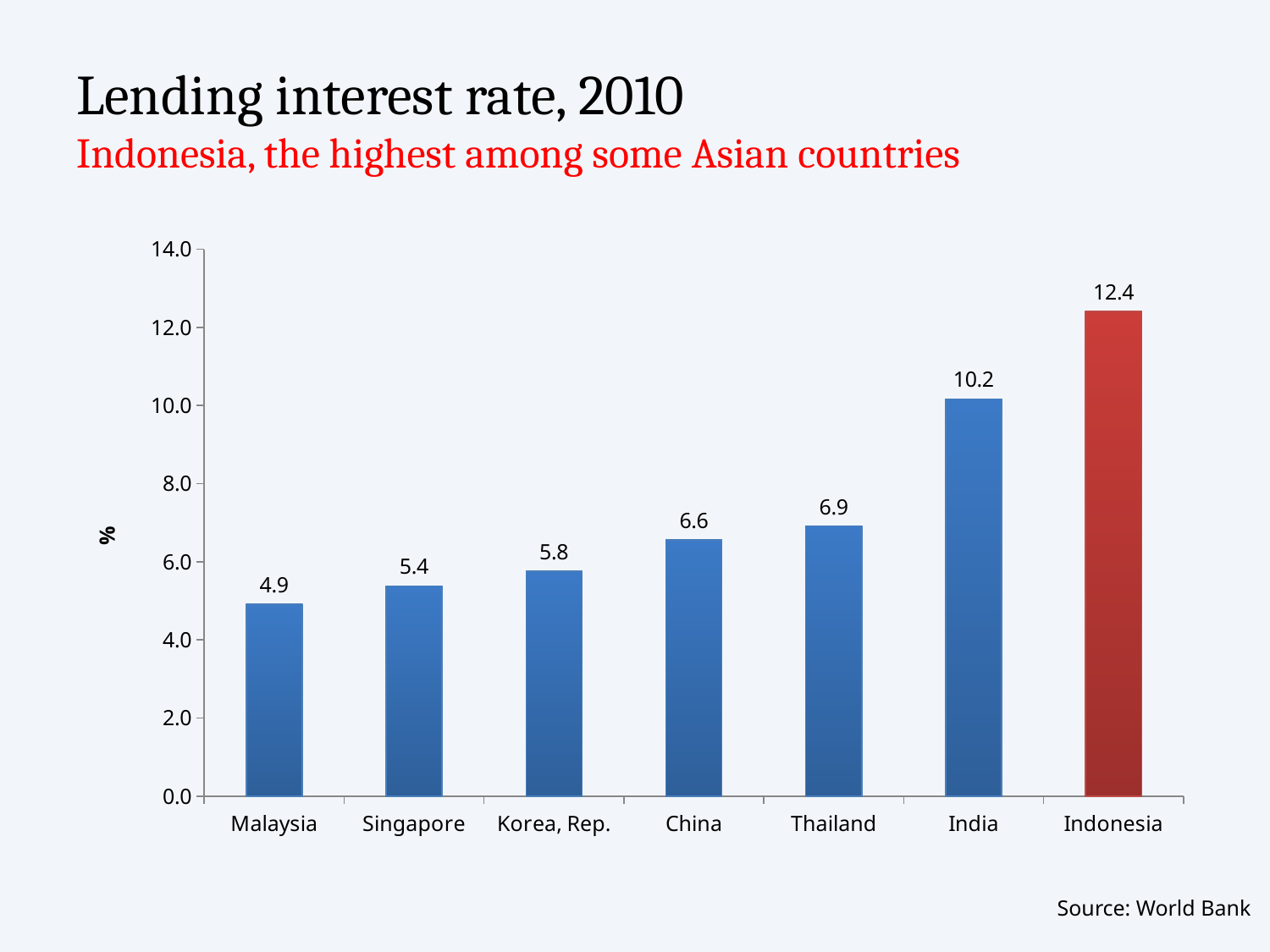
Which has a higher lending interest rate, Singapore or Thailand? Thailand What is the lending interest rate for India? 10.2 What is the difference between the values for Indonesia and India? 2.2 What is the difference between the values for Thailand and China? 0.3 What kind of chart is shown on the slide? bar chart Which country has the lowest lending interest rate? Malaysia What is the lending interest rate for Malaysia? 4.9 Is the value for China greater or less than 8.0? less What is the value shown for Korea, Rep.? 5.8 Which country has the highest lending interest rate? Indonesia How many countries are shown in the chart? 7 Which country's bar is coloured red rather than blue? Indonesia